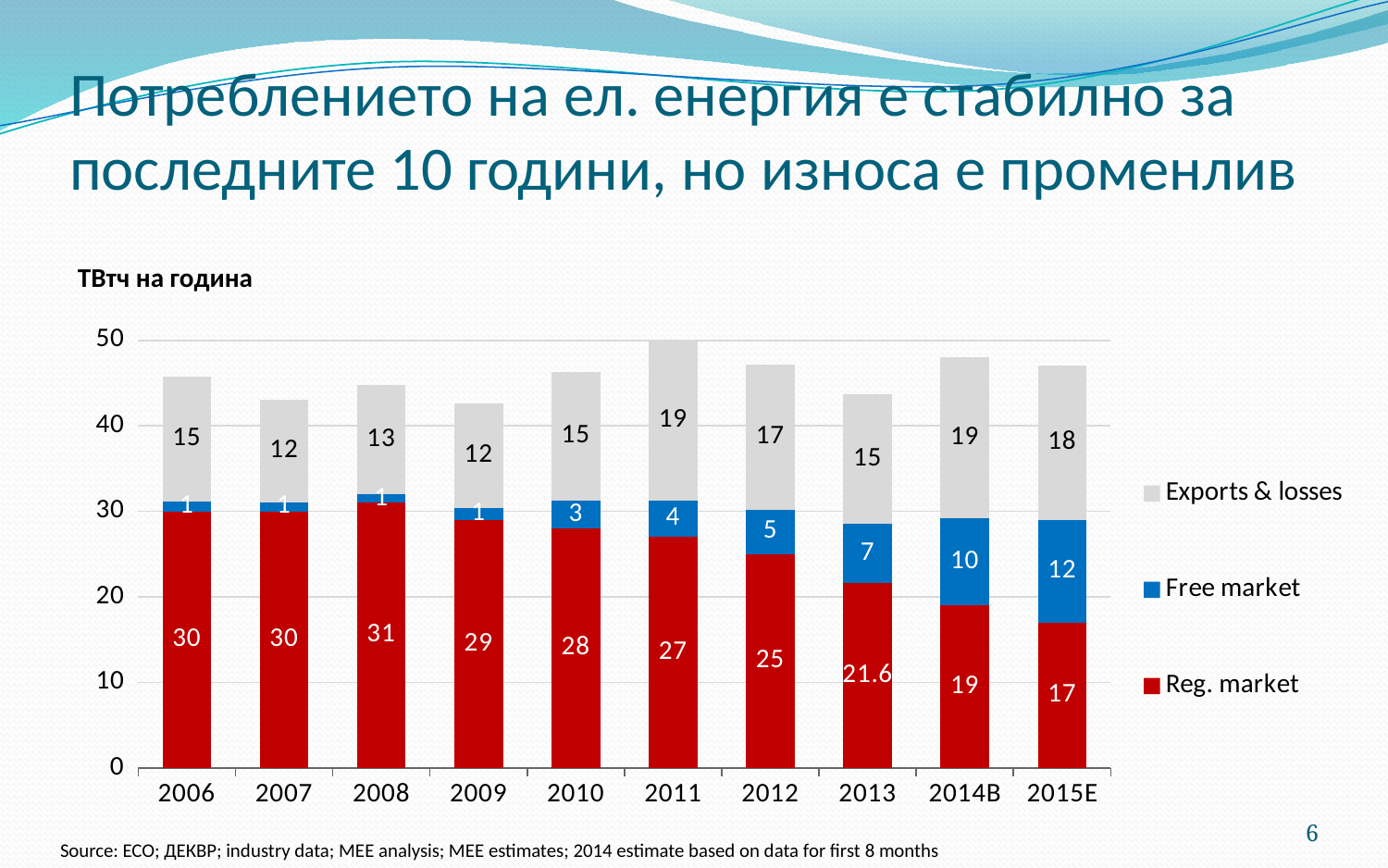
What is the Free market value for 2014B? 10 Which year has the highest Reg. market value? 2008 What is the Reg. market value for 2013? 21.6 What is the total of the stacked bar for 2011? 50 What is the Exports & losses value for 2011? 19 Does the Free market value rise or fall from 2010 to 2015E? rise Which is larger, the Free market value for 2012 or for 2013? 2013 How many series does the legend list? 3 How many years are shown on the x axis? 10 Which year has the lowest Reg. market value? 2015E What is the difference between the Reg. market values for 2006 and 2015E? 13 What is the total of the stacked bar for 2015E? 47